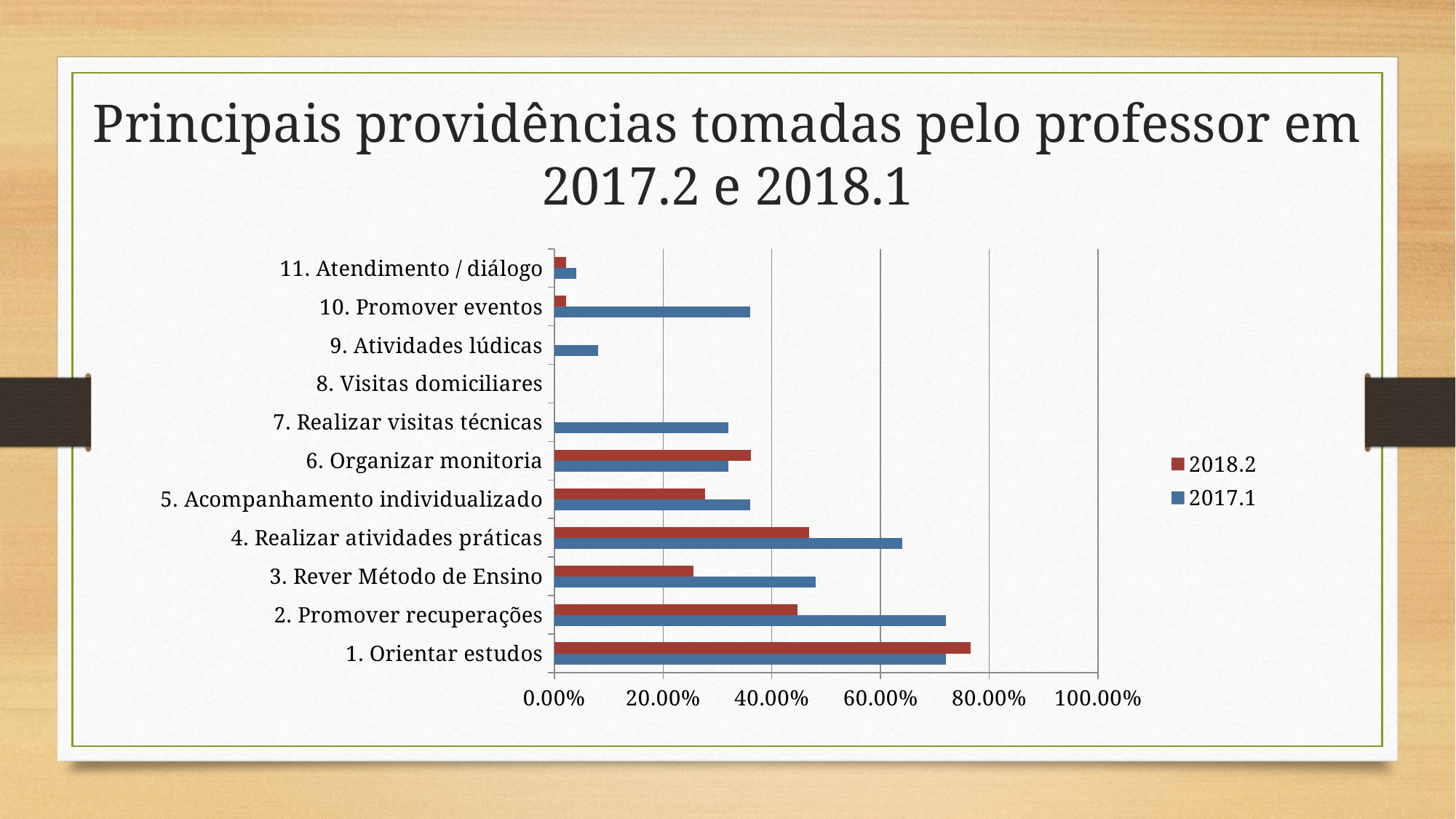
Which series is shown in red in the legend? 2018.2 Which category has the highest value for the 2018.2 series? 1. Orientar estudos What is the title of the slide containing the chart? Principais providências tomadas pelo professor em 2017.2 e 2018.1 What kind of chart is shown on the slide? bar chart Is the 2017.1 value for '2. Promover recuperações' greater or less than 60.00%? greater For '3. Rever Método de Ensino', which series has the larger value, 2017.1 or 2018.2? 2017.1 For '2. Promover recuperações', which series has the larger value, 2017.1 or 2018.2? 2017.1 Is the 2017.1 value for '4. Realizar atividades práticas' greater or less than 60.00%? greater Is the 2018.2 value for '3. Rever Método de Ensino' greater or less than 40.00%? less How many series does the legend list? 2 How many categories are shown on the chart? 11